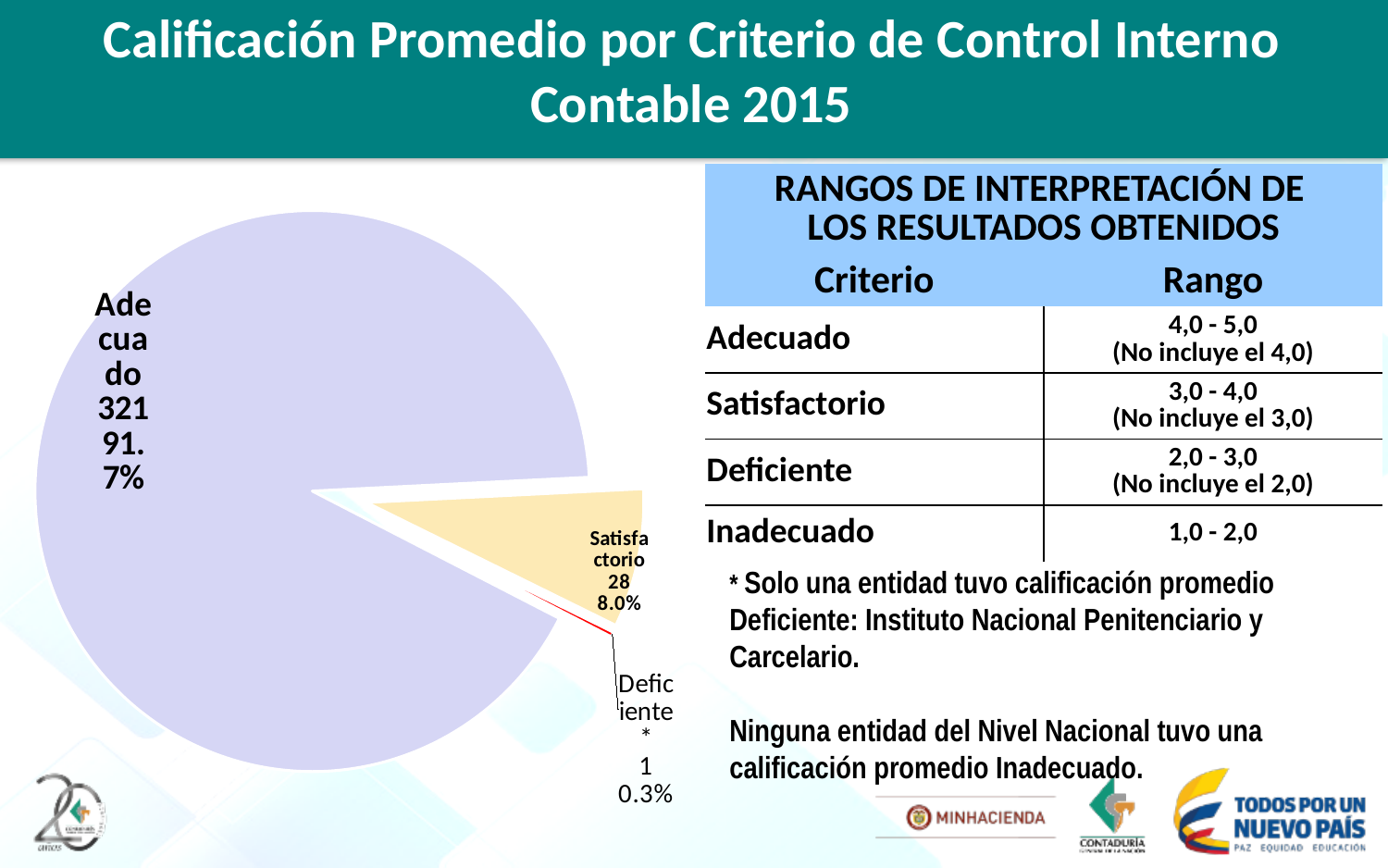
Which category has the largest slice in the pie chart? Adecuado What is the total number of entities across all slices of the pie chart? 350 Which category has the smallest slice in the pie chart? Deficiente How many slices does the pie chart have? 3 What is the difference in number of entities between the Adecuado and Satisfactorio slices? 293 What share of the pie does the Deficiente slice represent? 0.3% How many entities are in the Satisfactorio slice of the pie chart? 28 How many entities are in the Deficiente slice of the pie chart? 1 How many entities are in the Adecuado slice of the pie chart? 321 What share of the pie does the Adecuado slice represent? 91.7% What share of the pie does the Satisfactorio slice represent? 8.0% What kind of chart is shown on the slide? Pie chart